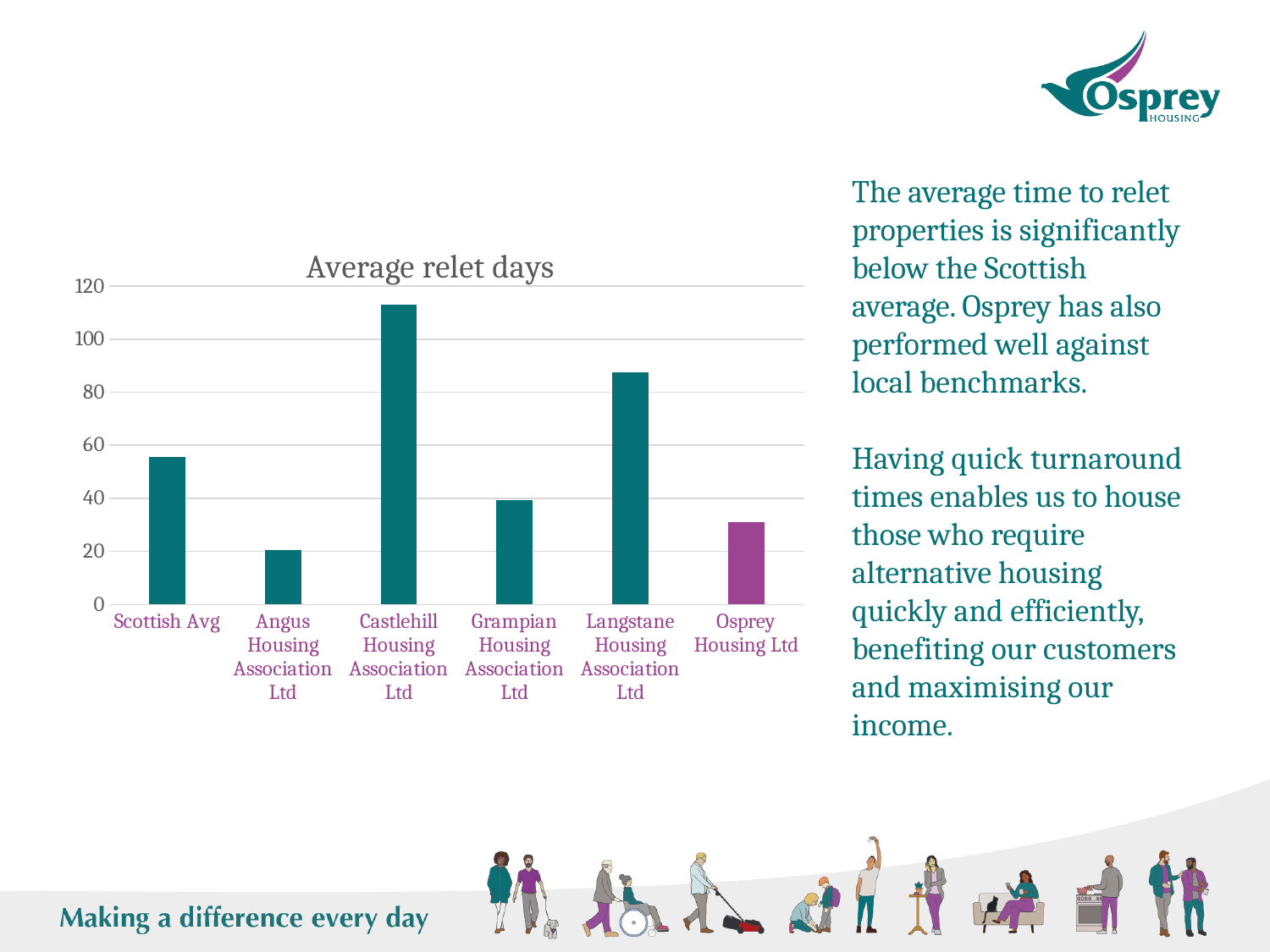
Which category has the highest average relet days? Castlehill Housing Association Ltd Is the value for Langstane Housing Association Ltd greater or less than 80? greater What is the title of the chart? Average relet days Which has more average relet days, Castlehill Housing Association Ltd or Langstane Housing Association Ltd? Castlehill Housing Association Ltd Which bar is shown in a different colour (purple) from the others? Osprey Housing Ltd How many categories are plotted in the chart? 6 Is the value for Castlehill Housing Association Ltd greater or less than 100? greater What kind of chart is shown on the slide? Bar chart Is the value for Osprey Housing Ltd greater or less than 40? less Which category has the lowest average relet days? Angus Housing Association Ltd Which has more average relet days, Scottish Avg or Osprey Housing Ltd? Scottish Avg Which has more average relet days, Osprey Housing Ltd or Angus Housing Association Ltd? Osprey Housing Ltd